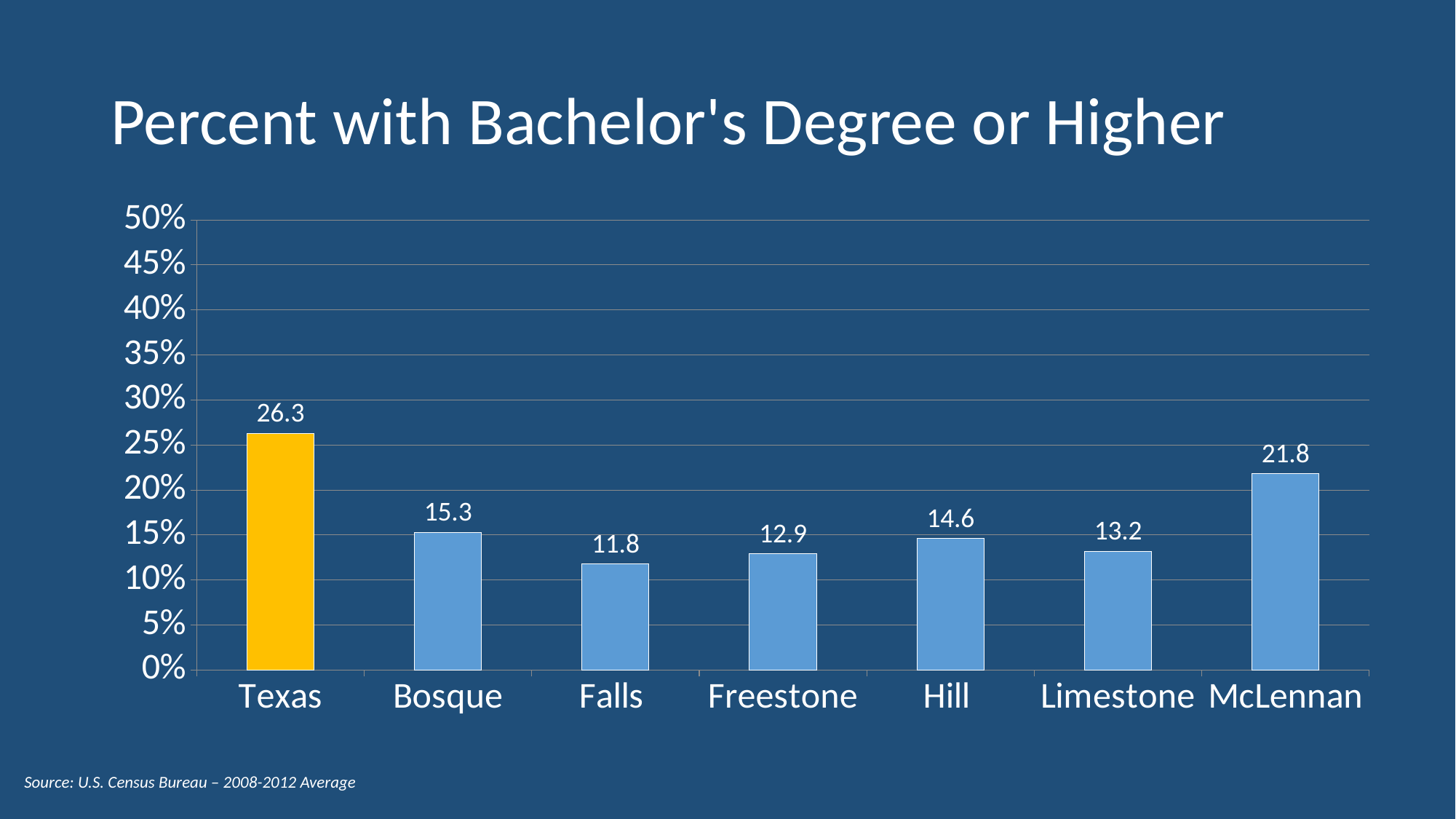
What is the difference between the values for Bosque and Hill? 0.7 Which category has the highest value? Texas Which category has the lowest value? Falls What is the title of the chart? Percent with Bachelor's Degree or Higher What kind of chart is shown on the slide? bar chart Which is larger, the value for Limestone or the value for Hill? Hill How many categories are shown on the x axis? 7 Is the value for McLennan greater or less than 20%? greater What is the value for Texas? 26.3 What is the value for Falls? 11.8 What is the difference between the values for Texas and McLennan? 4.5 What is the value for McLennan? 21.8